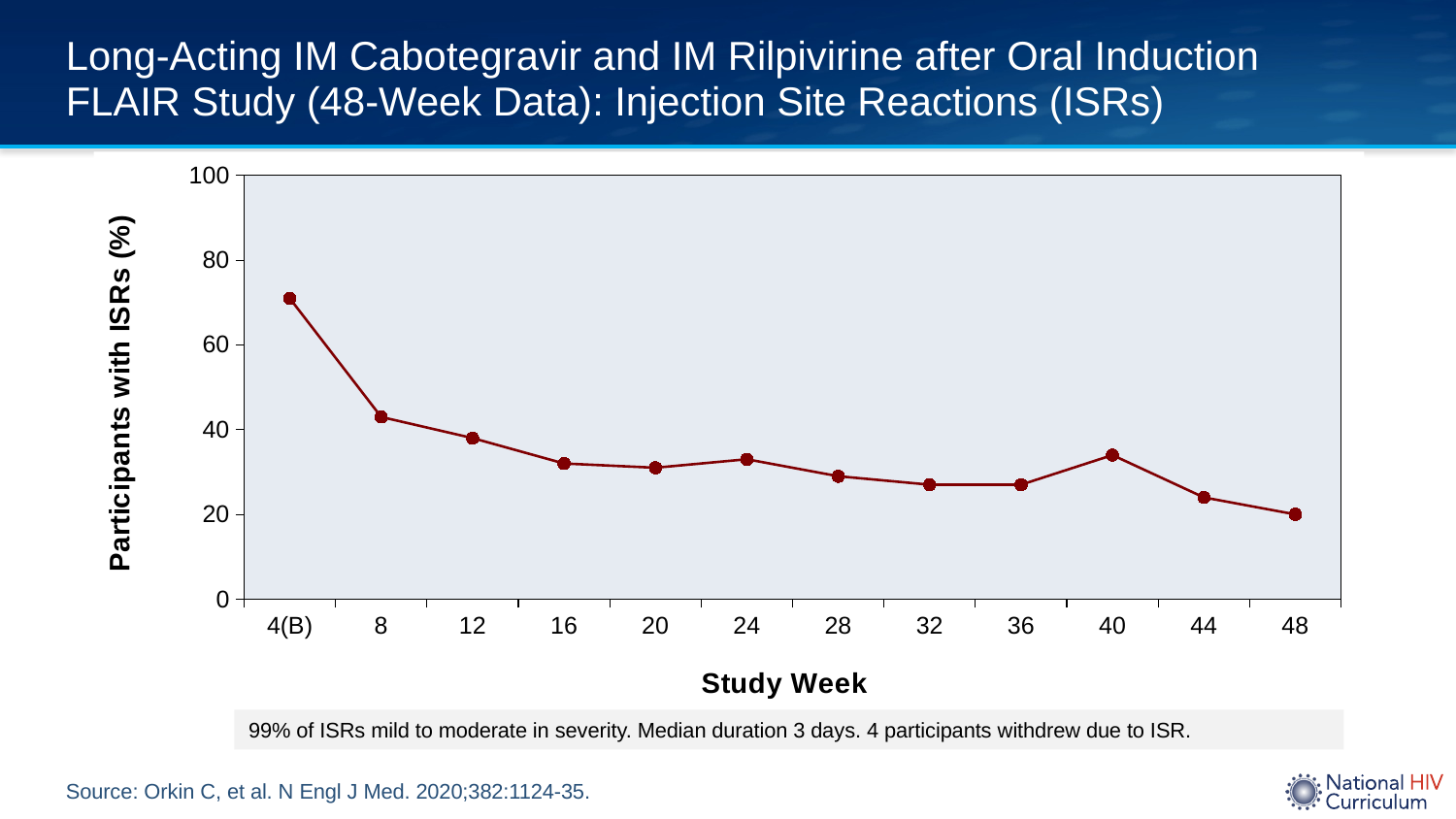
Is the value for week 16 greater or less than 40? less Is the value for week 8 greater or less than 40? greater What is the label of the y axis? Participants with ISRs (%) How many study week points are plotted on the chart? 12 Is the value for week 4(B) greater or less than 60? greater Which has a higher percentage of participants with ISRs, week 4(B) or week 8? week 4(B) Do the values generally rise or fall from week 4(B) to week 48? fall What kind of chart is shown on the slide? line chart At which study week is the percentage of participants with ISRs lowest? 48 Which has a higher percentage of participants with ISRs, week 36 or week 40? week 40 At which study week is the percentage of participants with ISRs highest? 4(B)